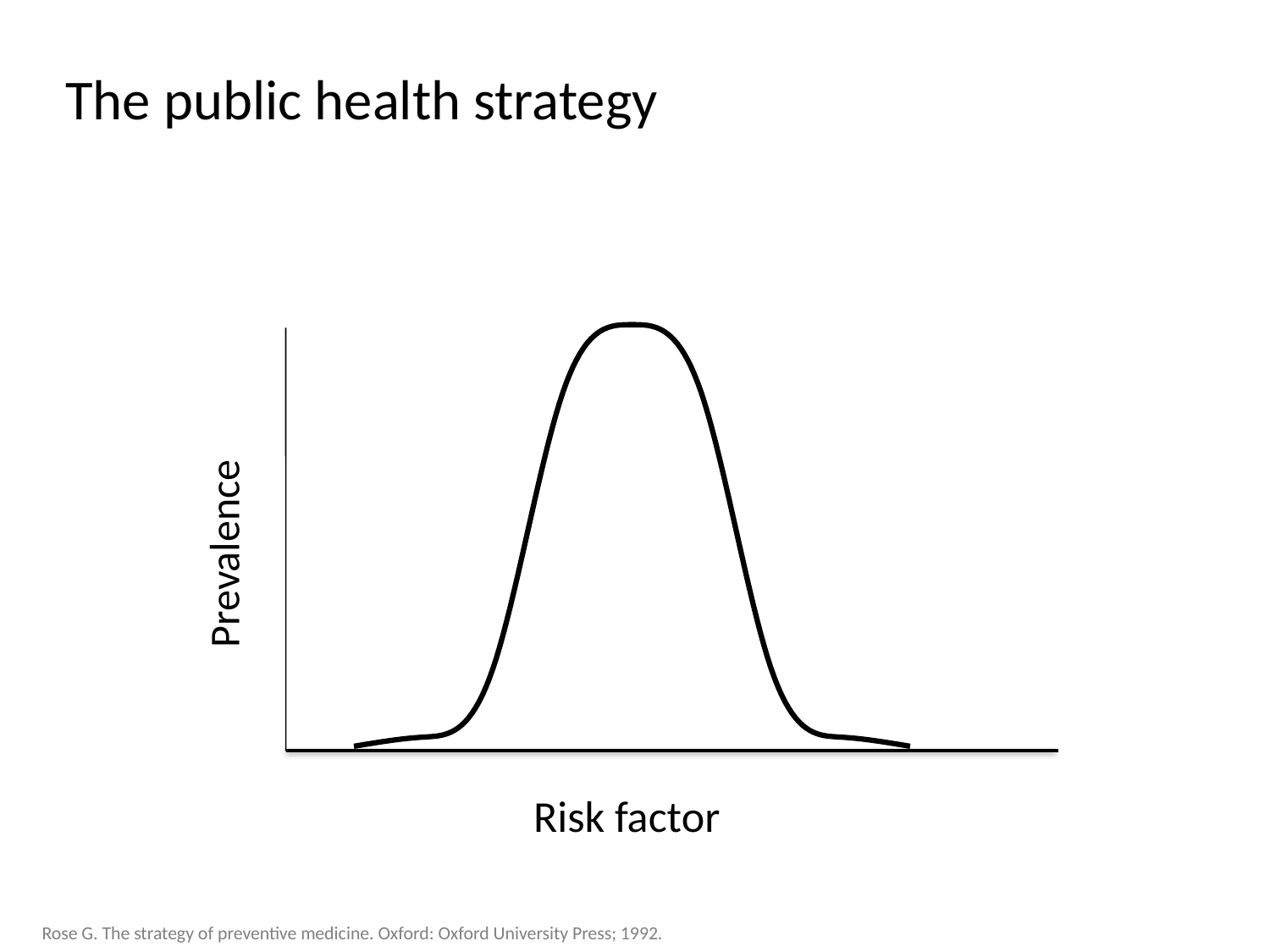
What is the label of the horizontal axis of the chart? Risk factor How does prevalence change as the risk factor increases along the x axis? It rises to a peak and then falls How many curves are plotted on the chart? 1 Where along the risk factor axis is prevalence lowest: at the extremes or in the middle? At the extremes Is the peak of the curve located near the left end, the middle, or the right end of the risk factor axis? The middle What is the label of the vertical axis of the chart? Prevalence What kind of chart is shown on the slide? Line chart